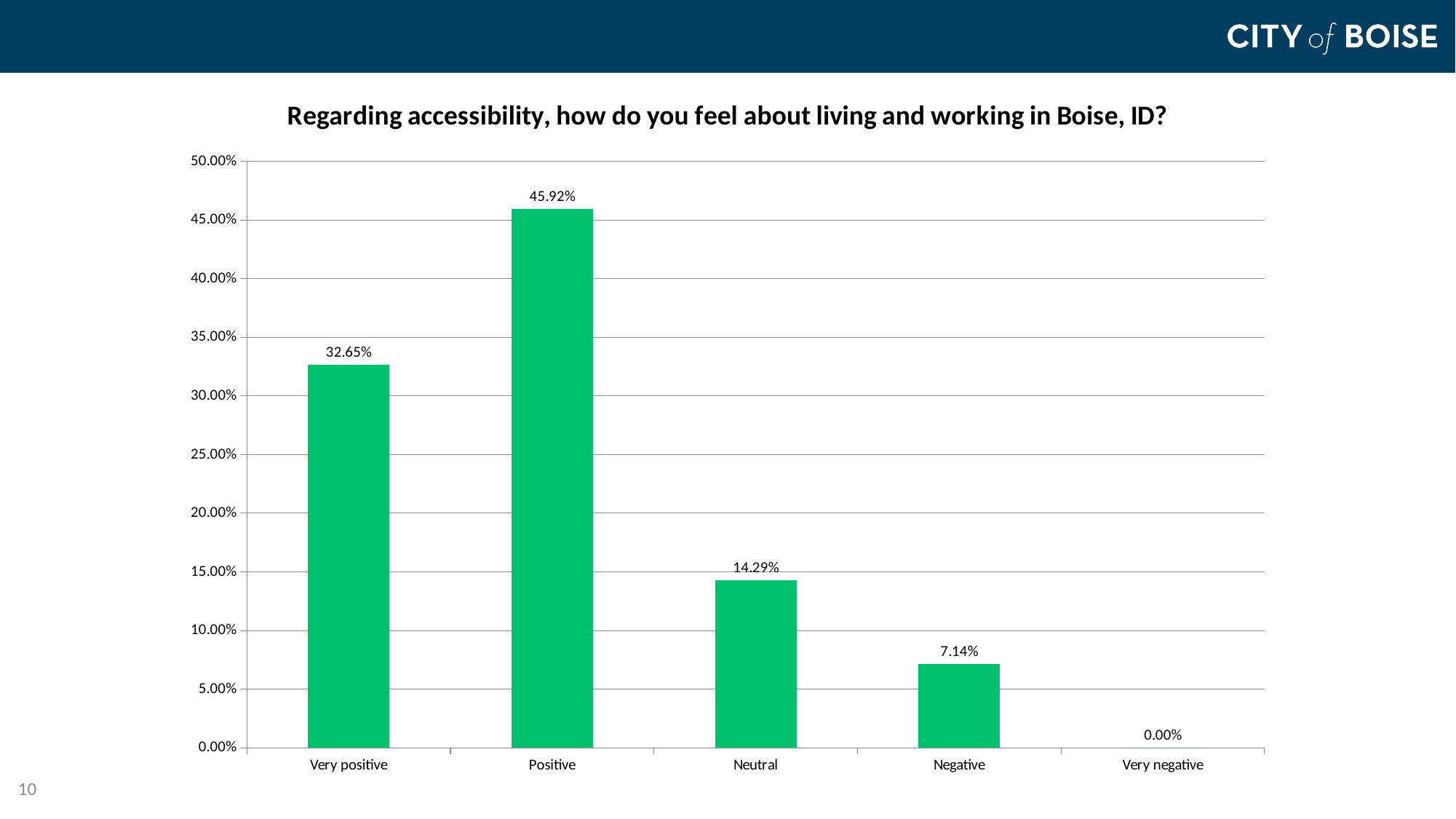
Is the value for "Negative" greater or less than 10.00%? less What percentage of respondents answered "Very positive"? 32.65% What is the value shown for "Very negative"? 0.00% What percentage of respondents answered "Positive"? 45.92% Which is larger, the value for "Neutral" or the value for "Negative"? Neutral What kind of chart is shown on the slide? Bar chart What is the title of the chart? Regarding accessibility, how do you feel about living and working in Boise, ID? How many response categories are shown on the x axis? 5 Which response category has the lowest value? Very negative Which response category has the highest value? Positive What is the value shown for "Neutral"? 14.29% What is the difference between the "Positive" and "Very positive" values? 13.27%